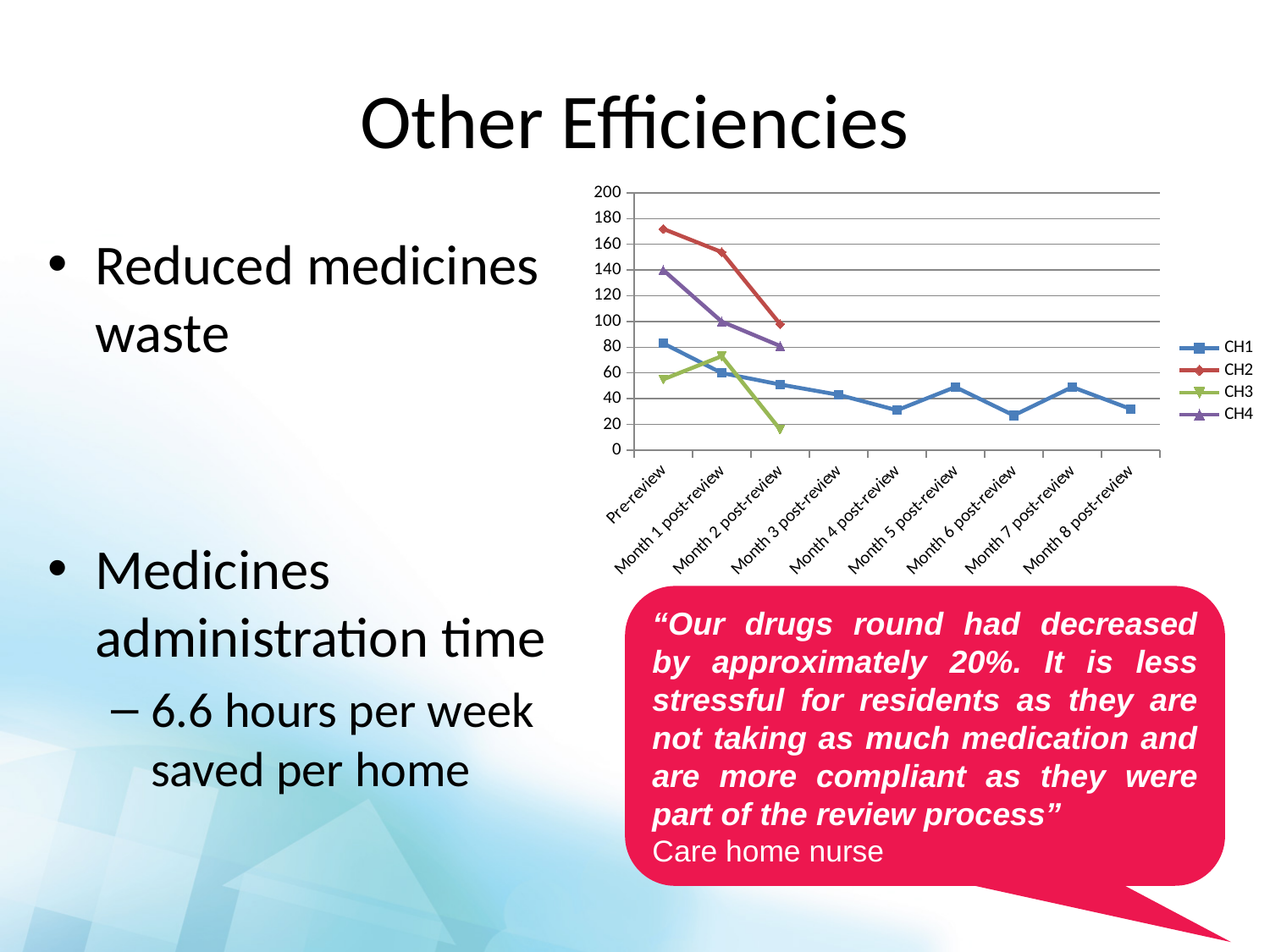
What kind of chart is shown on the slide? line chart How many categories are shown along the x axis? 9 Which series has the highest value at Pre-review? CH2 Which is larger at Month 1 post-review, CH3 or CH1? CH3 Does the CH2 series rise or fall from Pre-review to Month 2 post-review? fall Is the value for CH4 at Pre-review greater or less than 120? greater Which series has the lowest value at Month 2 post-review? CH3 What is the label of the first category on the x axis? Pre-review How many series does the legend list? 4 Which series extends all the way to Month 8 post-review? CH1 Is the value for CH2 at Pre-review greater or less than 160? greater Is the value for CH3 at Month 2 post-review greater or less than 20? less